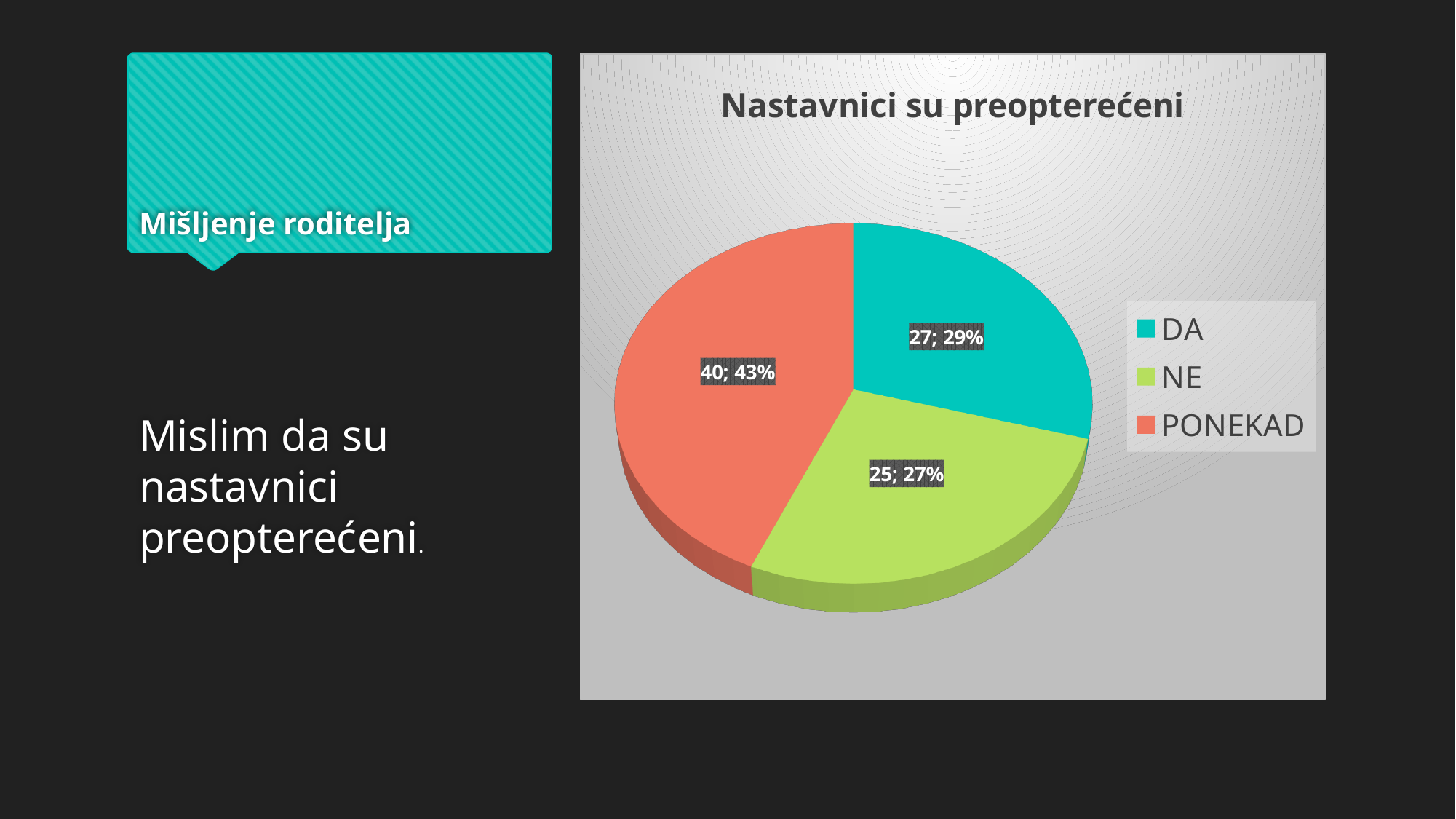
What is the count for the NE slice? 25 What percentage share does the DA slice have? 29% Which category has the smallest slice? NE How many entries does the legend list? 3 What is the title of the chart? Nastavnici su preopterećeni Which category has the largest slice? PONEKAD What is the difference between the counts for PONEKAD and DA? 13 How many slices does the pie chart have? 3 What percentage share does the PONEKAD slice have? 43% What is the count for the DA slice? 27 What type of chart is shown on the slide? pie chart What is the count for the PONEKAD slice? 40